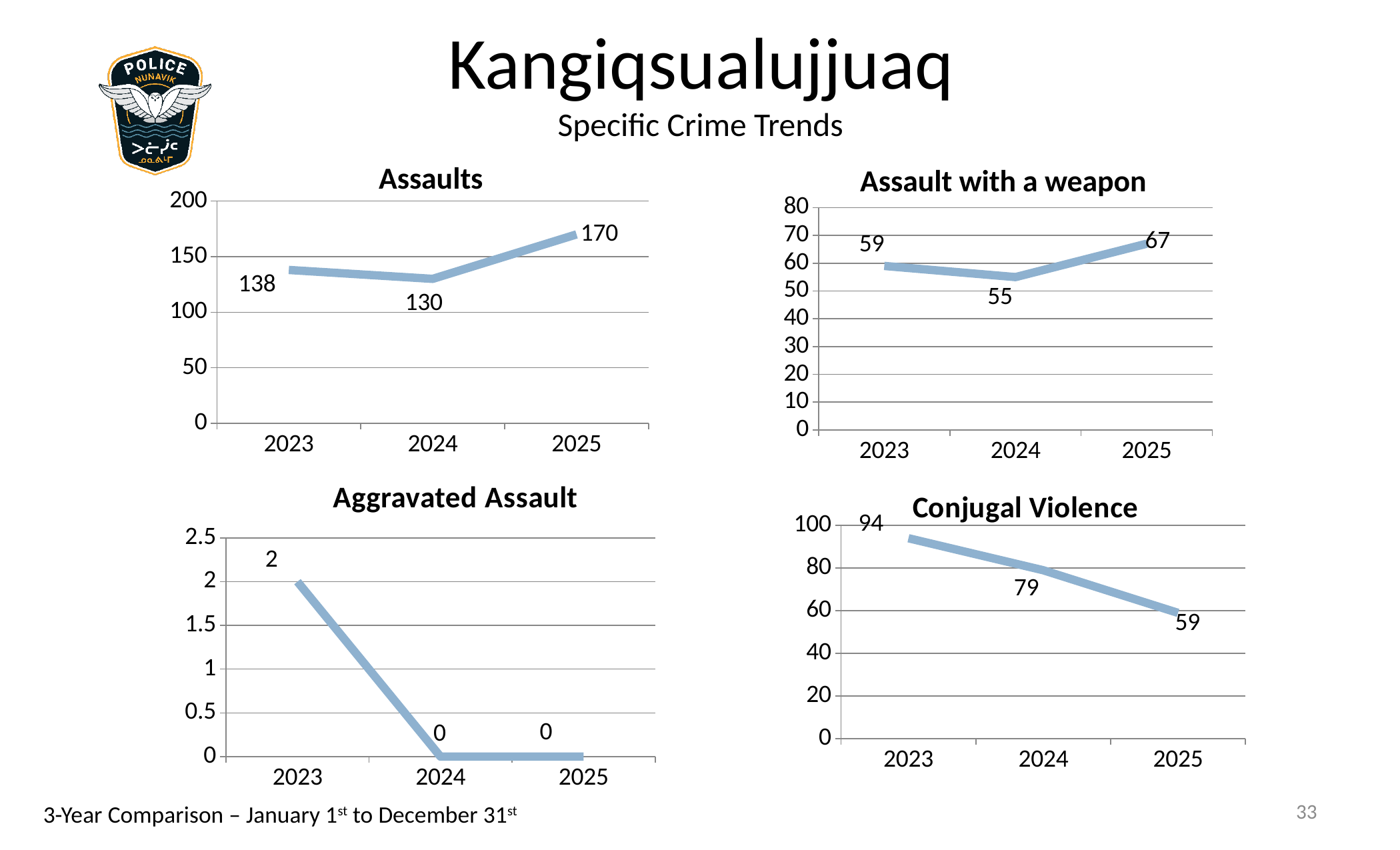
In the Aggravated Assault chart, how many years are plotted on the x axis? 3 In the Conjugal Violence chart, what is the difference between the 2023 and 2025 values? 35 In the Assaults chart, which year has the lowest value? 2024 What kind of chart is the Assaults chart? line chart In the Aggravated Assault chart, what is the value for 2023? 2 In the Assault with a weapon chart, is the value for 2023 larger or smaller than the value for 2025? smaller In the Assaults chart, what is the difference between the 2025 and 2023 values? 32 In the Conjugal Violence chart, what is the value for 2024? 79 In the Assault with a weapon chart, what is the value for 2024? 55 In the Conjugal Violence chart, do the values rise or fall from 2023 to 2025? fall In the Assaults chart, what is the value for 2025? 170 In the Assault with a weapon chart, which year has the highest value? 2025